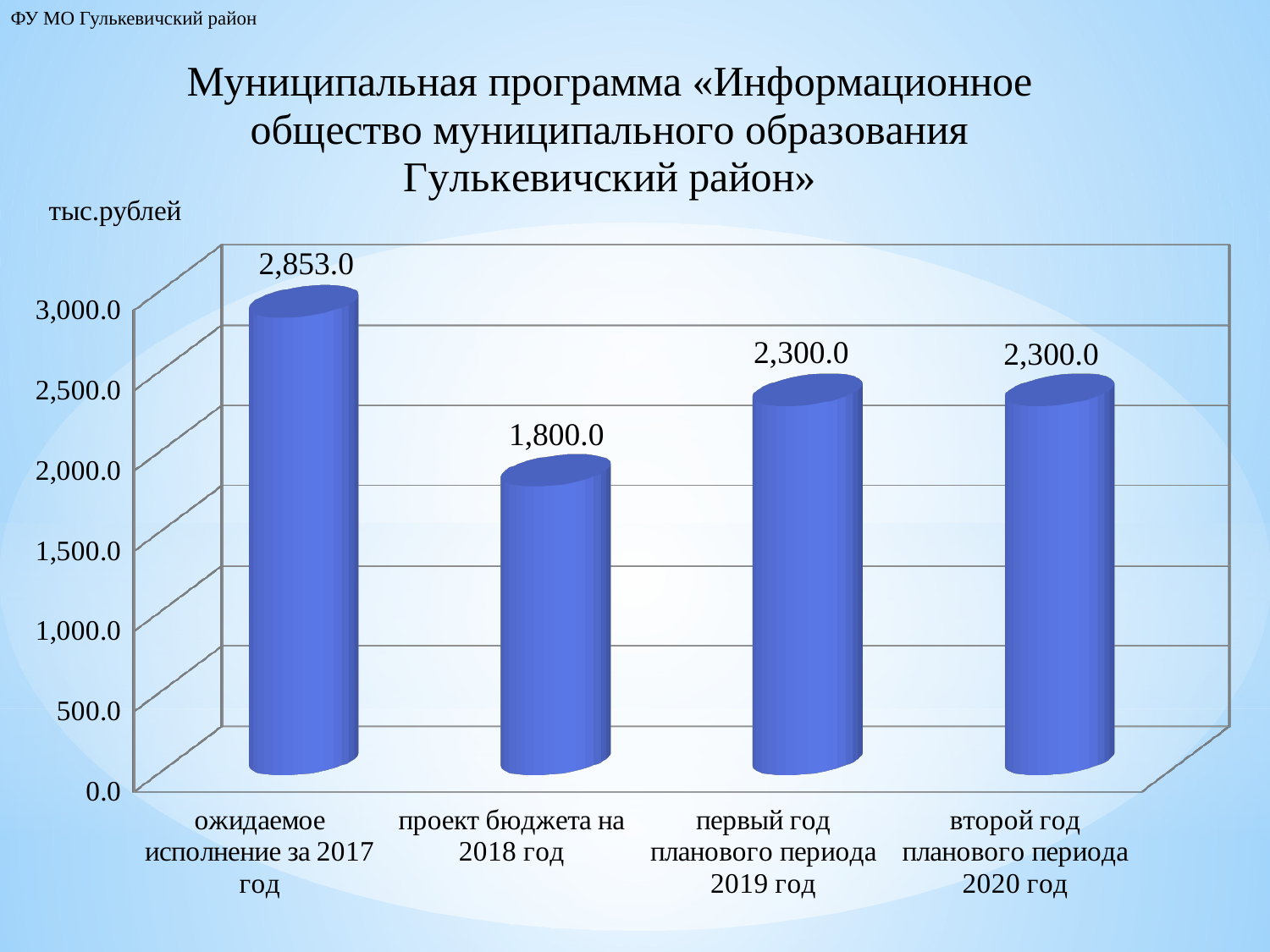
What kind of chart is shown on the slide? bar chart How many categories are shown on the chart? 4 What is the difference between the value for 'первый год планового периода 2019 год' and the value for 'проект бюджета на 2018 год'? 500.0 What is the value for 'второй год планового периода 2020 год'? 2,300.0 What is the value for 'проект бюджета на 2018 год'? 1,800.0 What is the value for 'первый год планового периода 2019 год'? 2,300.0 What unit is indicated above the chart's vertical axis? тыс.рублей Which category has the lowest value? проект бюджета на 2018 год What is the value for 'ожидаемое исполнение за 2017 год'? 2,853.0 What is the difference between the value for 'ожидаемое исполнение за 2017 год' and the value for 'проект бюджета на 2018 год'? 1,053.0 Which category has the highest value? ожидаемое исполнение за 2017 год Which is larger: the value for 'проект бюджета на 2018 год' or the value for 'второй год планового периода 2020 год'? второй год планового периода 2020 год